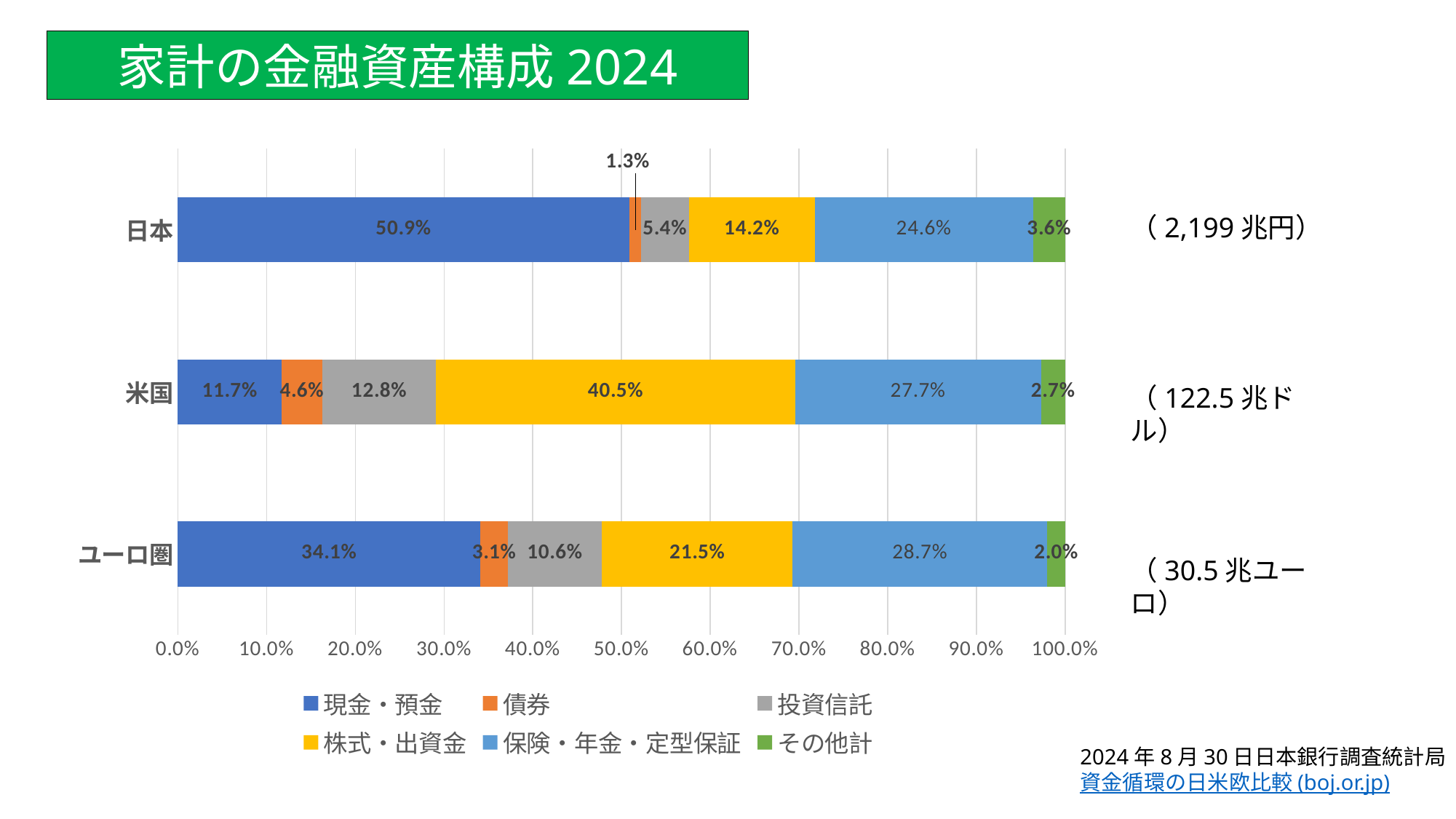
What is the title of the slide? 家計の金融資産構成 2024 How many regions are shown on the chart? 3 What share of household financial assets in 日本 is 現金・預金? 50.9% What kind of chart is shown on the slide? Stacked bar chart How many series does the legend list? 6 Which region has the lowest 株式・出資金 share? 日本 What is the 債券 share for 日本? 1.3% How much larger is the 株式・出資金 share in 米国 than in 日本? 26.3% What share of household financial assets in ユーロ圏 is 保険・年金・定型保証? 28.7% Which region has the highest 現金・預金 share? 日本 Which is larger: the 投資信託 share in 米国 or in ユーロ圏? 米国 What share of household financial assets in 米国 is 株式・出資金? 40.5%